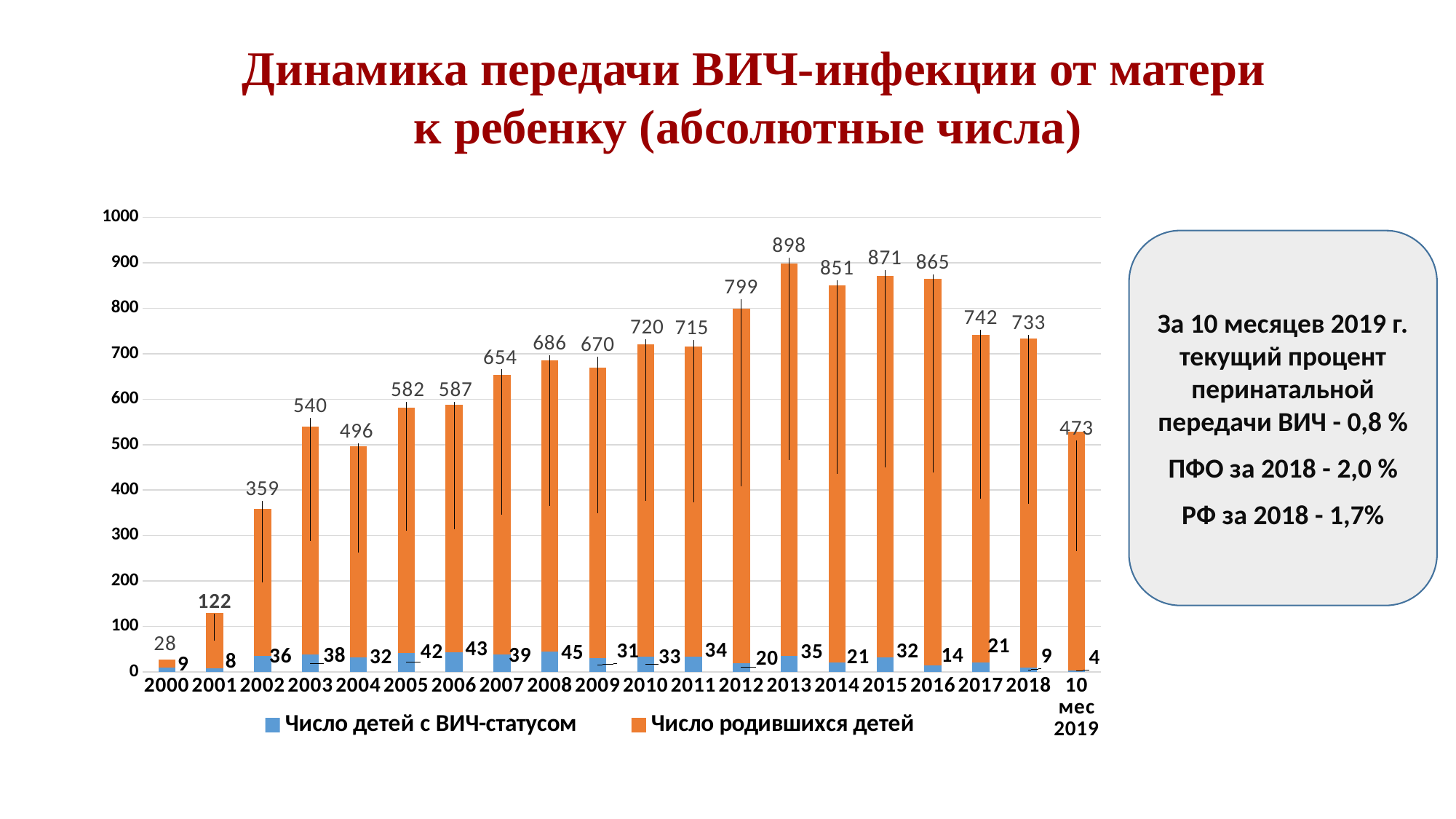
Which category has the lowest value of "Число детей с ВИЧ-статусом"? 10 мес 2019 Which year has the highest value of "Число родившихся детей"? 2013 What is the value of "Число родившихся детей" for "10 мес 2019"? 473 What is the value of "Число детей с ВИЧ-статусом" for 2008? 45 Is the value of "Число родившихся детей" for 2003 greater or less than 500? greater Which is larger, the "Число родившихся детей" value for 2015 or for 2016? 2015 What is the value of "Число родившихся детей" for 2013? 898 What kind of chart is shown on the slide? bar chart What is the difference between the "Число родившихся детей" values for 2013 and 2000? 870 Which series is shown in orange? Число родившихся детей How many categories are shown on the x axis? 20 How many series does the legend list? 2